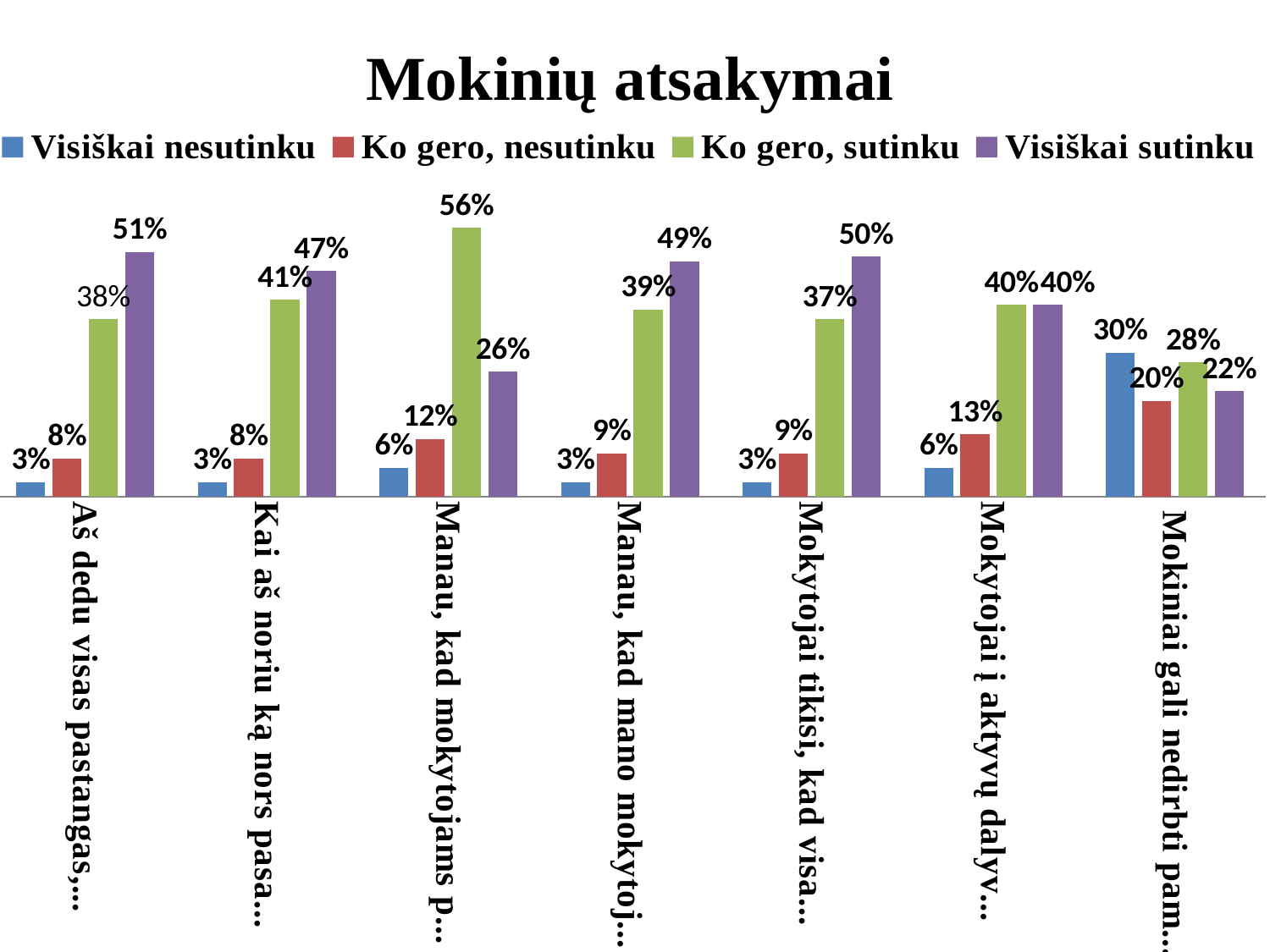
Which category has the highest "Ko gero, sutinku" value? Manau, kad mokytojams p... How many series does the legend list? 4 How many categories are shown along the x axis? 7 For the category "Mokiniai gali nedirbti pam...", which is larger: "Visiškai nesutinku" or "Ko gero, nesutinku"? Visiškai nesutinku What is the difference between "Visiškai sutinku" and "Ko gero, sutinku" for the category "Aš dedu visas pastangas,..."? 13% What is the value of "Ko gero, sutinku" for the category "Manau, kad mokytojams p..."? 56% Which category has the lowest "Visiškai sutinku" value? Mokiniai gali nedirbti pam... What is the title of the chart? Mokinių atsakymai What kind of chart is shown on the slide? bar chart What is the value of "Ko gero, nesutinku" for the category "Mokytojai į aktyvų dalyv..."? 13% What is the value of "Visiškai nesutinku" for the category "Mokiniai gali nedirbti pam..."? 30% What is the value of "Visiškai sutinku" for the category "Aš dedu visas pastangas,..."? 51%